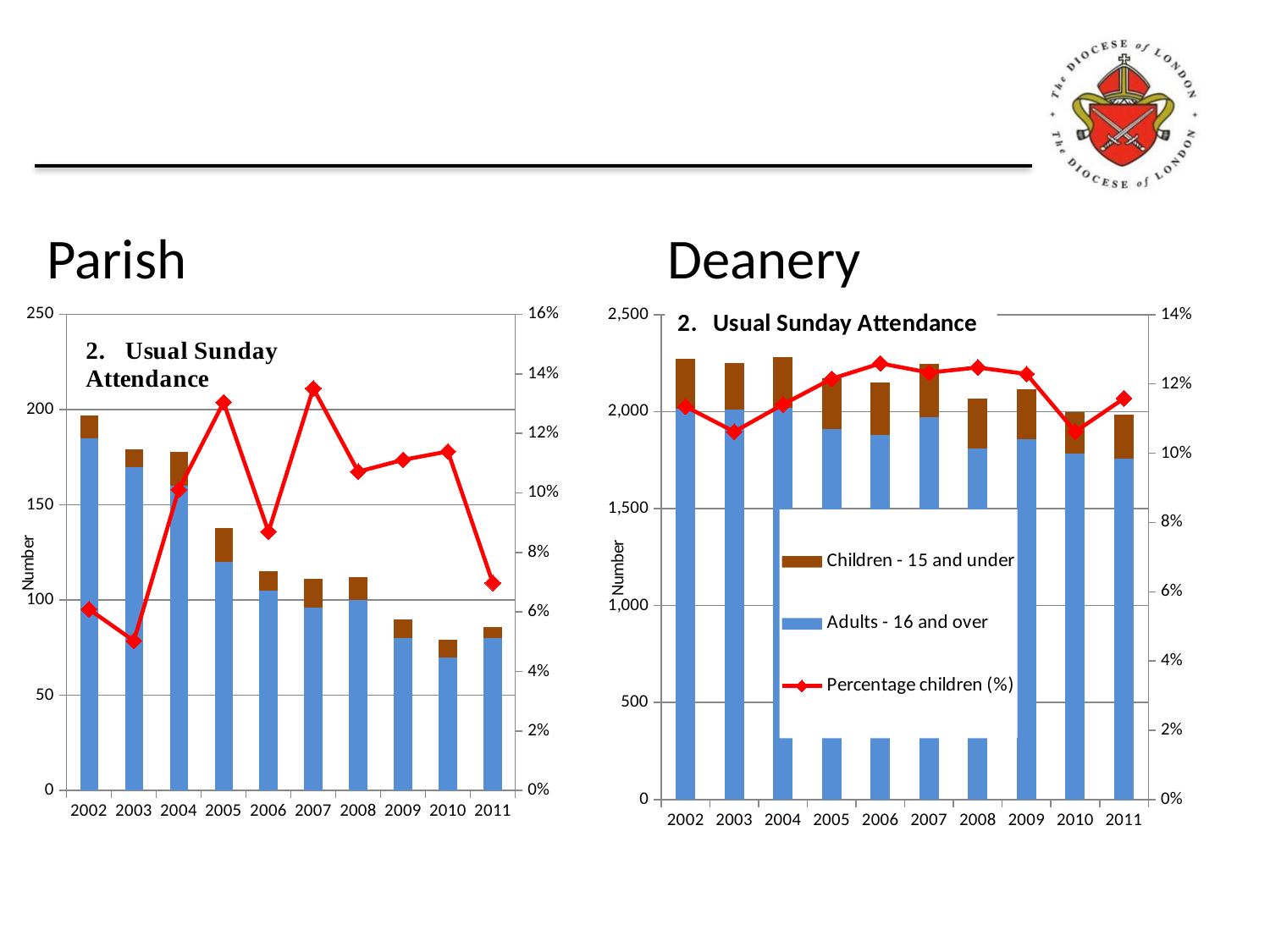
On the Parish chart, which year has the lowest total usual Sunday attendance? 2010 On the Parish chart, which year has the highest total usual Sunday attendance? 2002 On the Parish chart, does the total usual Sunday attendance rise or fall from 2002 to 2011? fall On the Parish chart, which year has the lowest percentage of children? 2003 On the Parish chart, is the percentage of children for 2011 greater or less than 8%? less What is the title shown inside both charts? 2. Usual Sunday Attendance On the Deanery chart, is the percentage of children for 2003 greater or less than 12%? less On the Parish chart, is the total attendance for 2002 greater or less than 150? greater How many series does the legend on the Deanery chart list? 3 How many years are shown on the x axis of the Deanery chart? 10 What kind of chart is the Parish chart? A combined stacked bar and line chart